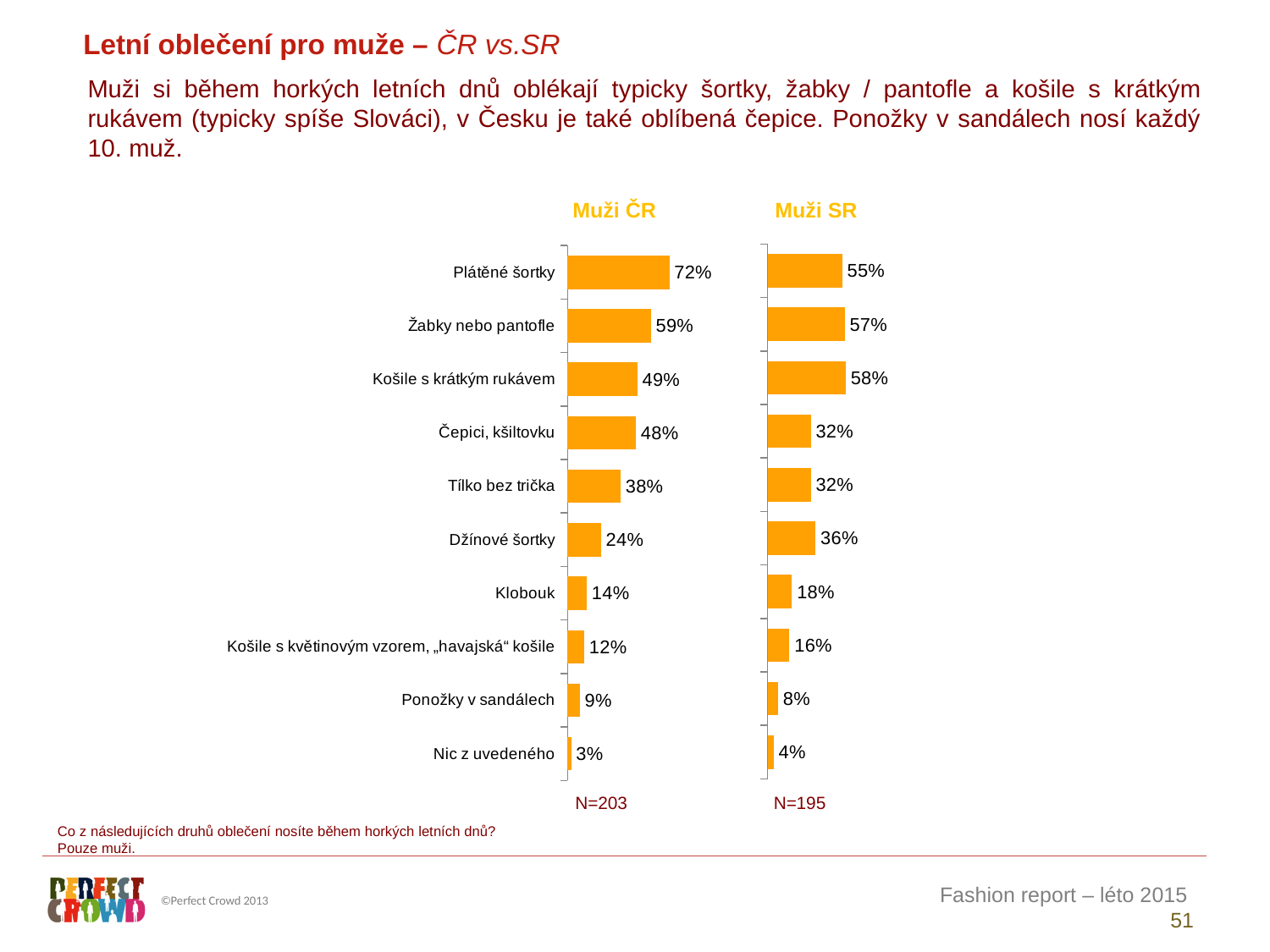
How many categories are shown in the Muži ČR chart? 10 What is the sample size (N) shown under the Muži SR chart? N=195 In the Muži SR chart, what is the value for Košile s krátkým rukávem? 58% In the Muži ČR chart, what is the value for Plátěné šortky? 72% In the Muži ČR chart, which is larger: Klobouk or Tílko bez trička? Tílko bez trička Which is larger: the Muži ČR value for Džínové šortky or the Muži SR value for Džínové šortky? Muži SR What type of chart is the Muži SR chart? Bar chart In the Muži ČR chart, which category has the highest value? Plátěné šortky In the Muži ČR chart, what is the difference between Plátěné šortky and Žabky nebo pantofle? 13% In the Muži SR chart, which category has the lowest value? Nic z uvedeného What is the difference between the Muži ČR and Muži SR values for Čepici, kšiltovku? 16% In the Muži SR chart, what is the value for Džínové šortky? 36%